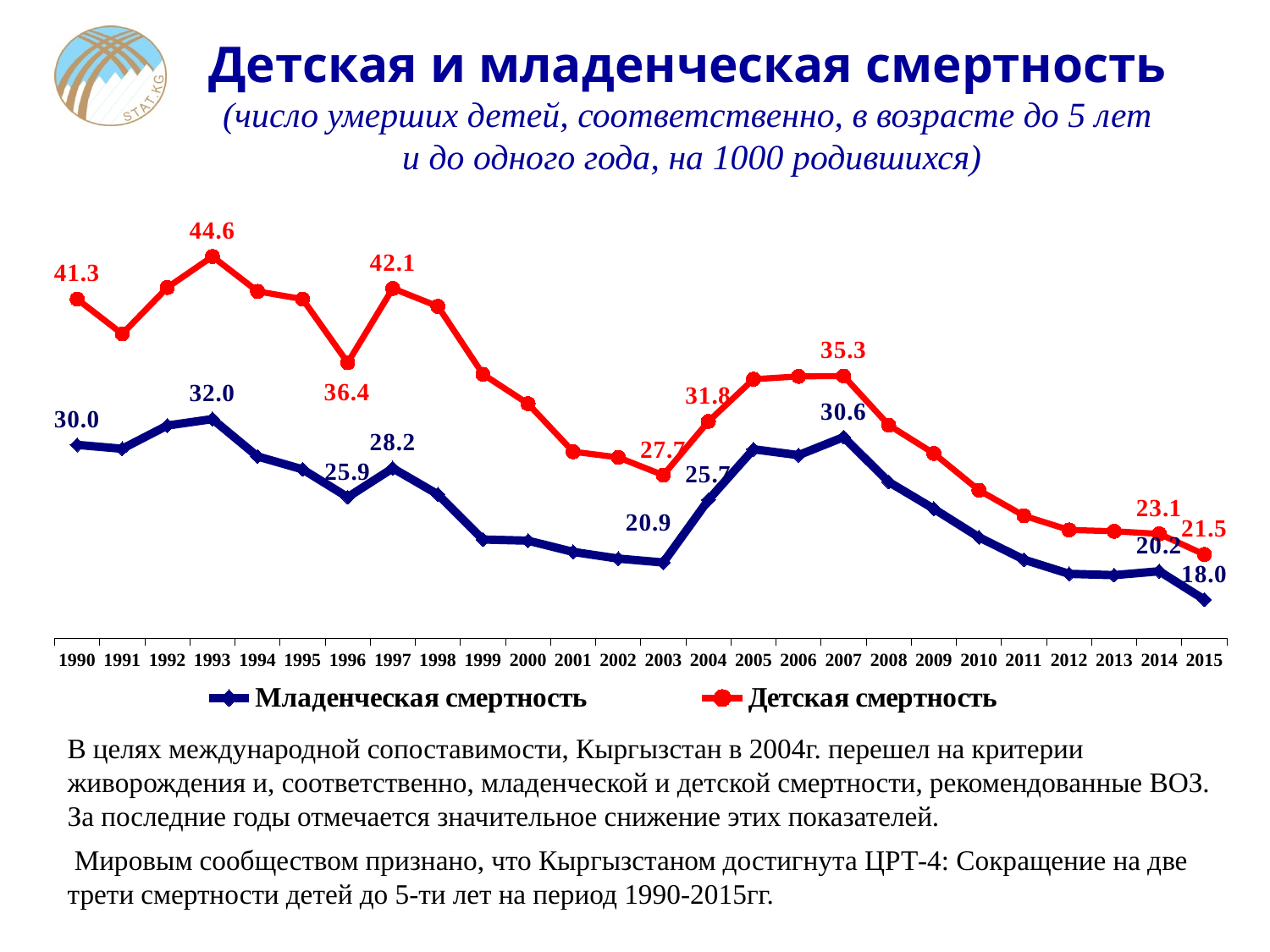
What is the value of Детская смертность in 2007? 35.3 What type of chart is shown on the slide? Line chart In which year is Младенческая смертность at its lowest? 2015 What is the value of Детская смертность in 1993? 44.6 How many series does the legend list? 2 In which year does Детская смертность reach its highest value? 1993 How many years are shown on the x axis? 26 Which is larger in 1990: Детская смертность or Младенческая смертность? Детская смертность Overall, do the values of Детская смертность rise or fall from 1990 to 2015? Fall What is the difference between Детская смертность and Младенческая смертность in 2015? 3.5 What is the value of Младенческая смертность in 2003? 20.9 What is the value of Младенческая смертность in 2015? 18.0